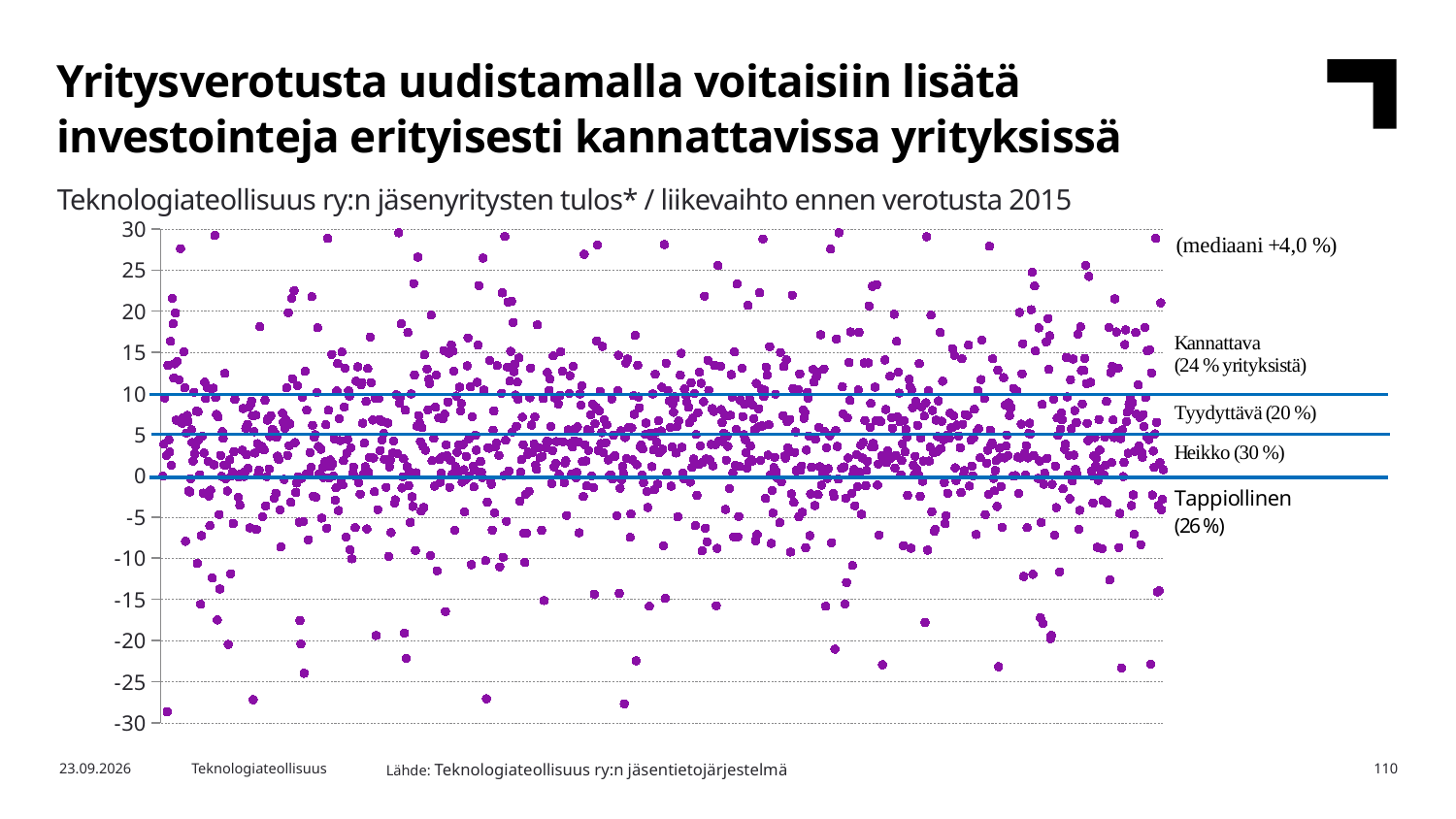
How many profitability categories are labelled on the chart? 4 What share of companies is labelled as Tyydyttävä? 20 % What share of companies is labelled as Tappiollinen? 26 % What is the median value stated on the chart? +4,0 % What share of companies is labelled as Kannattava? 24 % What is the difference in percentage points between the Heikko share and the Tyydyttävä share? 10 Which share is larger, Tappiollinen or Kannattava? Tappiollinen What kind of chart is shown on the slide? Scatter chart What share of companies is labelled as Heikko? 30 % Which of the four profitability categories has the largest share of companies? Heikko Which of the four profitability categories has the smallest share of companies? Tyydyttävä What is the title of the chart? Teknologiateollisuus ry:n jäsenyritysten tulos* / liikevaihto ennen verotusta 2015